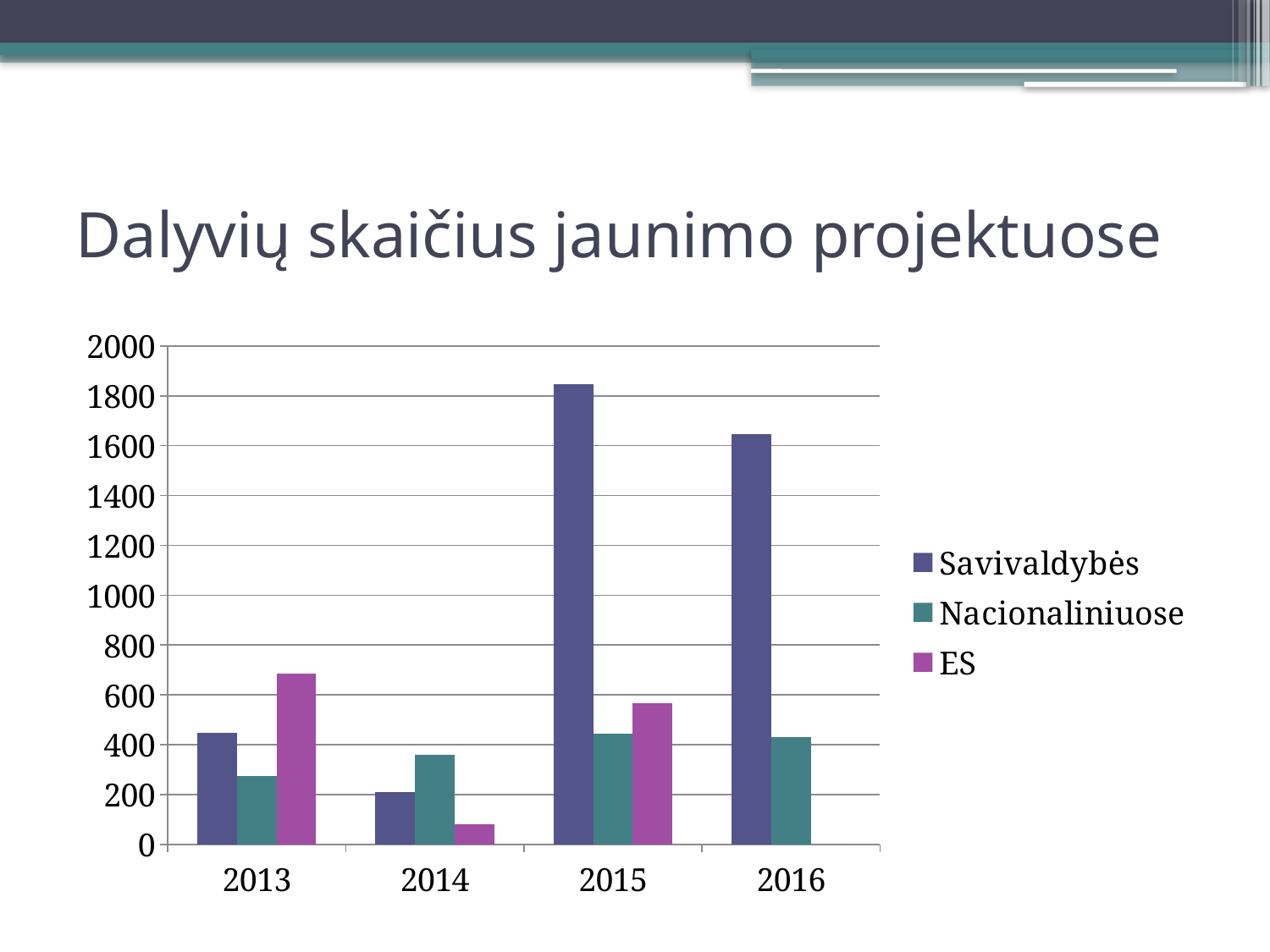
Is the ES value for 2013 greater or less than 600? greater Is the ES value for 2014 greater or less than 200? less In which year is the Savivaldybės value lowest? 2014 In 2014, which is larger: the Nacionaliniuose value or the Savivaldybės value? Nacionaliniuose Is the Savivaldybės value for 2015 greater or less than 1600? greater What is the title of the slide? Dalyvių skaičius jaunimo projektuose How many series does the legend list? 3 In 2013, which is larger: the ES value or the Savivaldybės value? ES In which year is the Savivaldybės value highest? 2015 What kind of chart is shown on the slide? bar chart How many years are shown on the x axis? 4